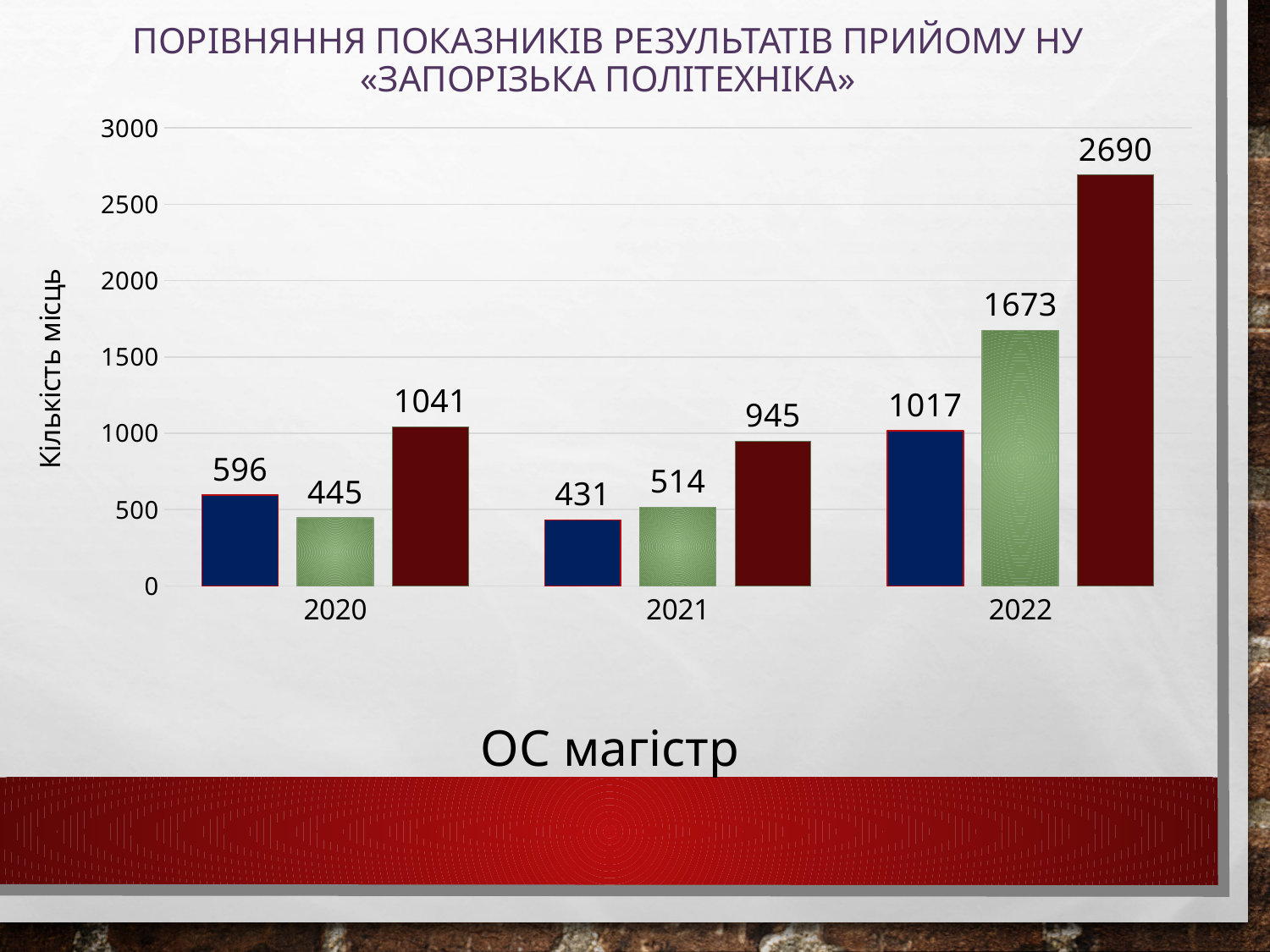
Do the green bar values rise or fall from 2020 to 2022? rise Which year has the lowest blue bar? 2021 What kind of chart is shown on the slide? bar chart How many years are shown on the x axis? 3 What is the difference between the dark red bar for 2022 and the dark red bar for 2021? 1745 Which is larger for 2021, the blue bar or the green bar? the green bar What is the label of the vertical axis? Кількість місць What is the value of the blue bar for 2021? 431 What is the difference between the blue bar and the green bar for 2020? 151 Which year has the highest dark red bar? 2022 What is the value of the dark red bar for 2022? 2690 What is the value of the green bar for 2020? 445